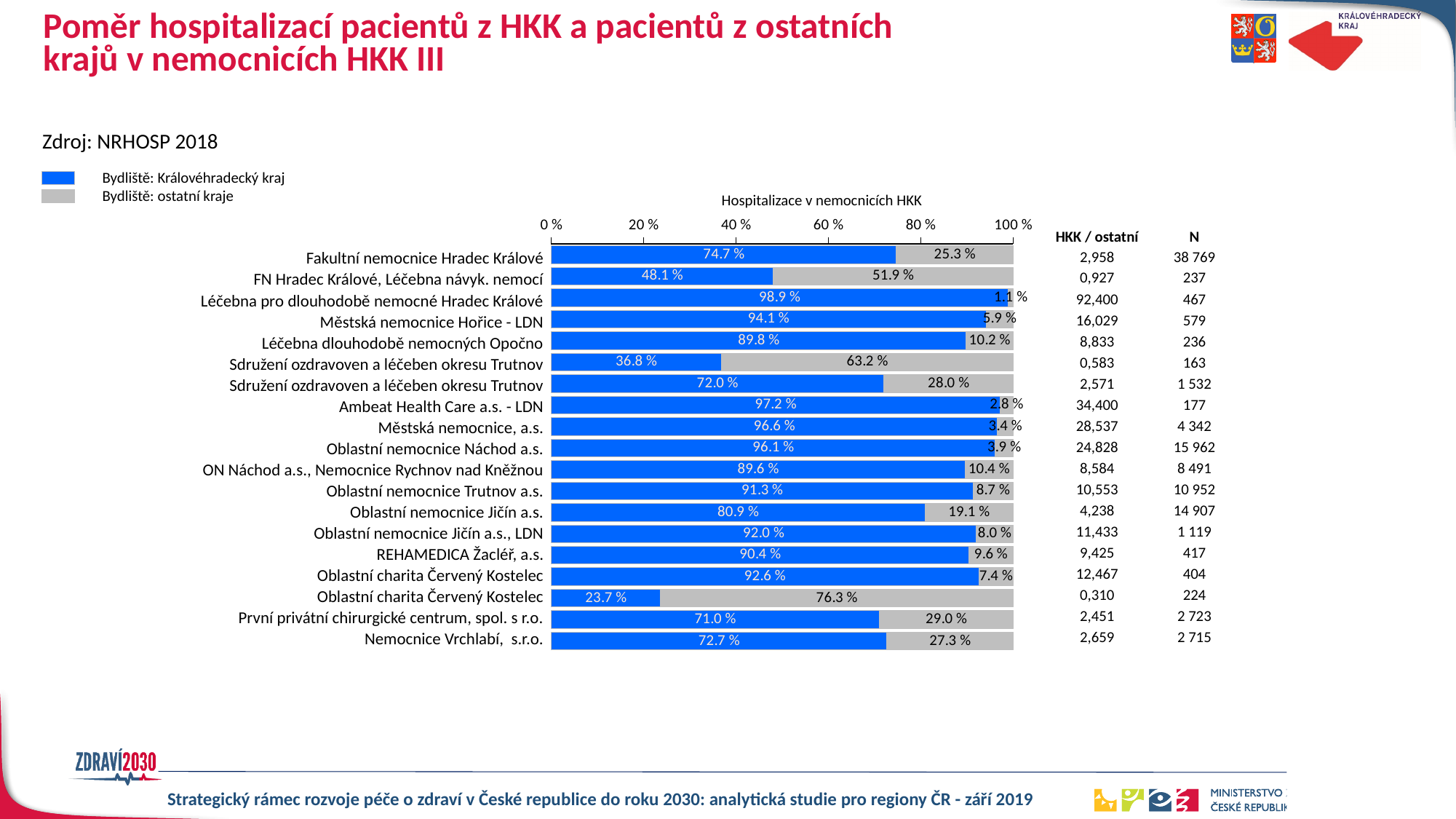
Which hospital has the highest share of patients with Bydliště: Královéhradecký kraj? Léčebna pro dlouhodobě nemocné Hradec Králové Which has a larger Bydliště: Královéhradecký kraj share, Oblastní nemocnice Jičín a.s. or Oblastní nemocnice Trutnov a.s.? Oblastní nemocnice Trutnov a.s. Which hospital has the lowest share of patients with Bydliště: Královéhradecký kraj? Oblastní charita Červený Kostelec How many hospitals (categories) are plotted in the chart? 19 What is the value for Bydliště: Královéhradecký kraj for Fakultní nemocnice Hradec Králové? 74.7 % What kind of chart is shown on the slide? Stacked bar chart What is the title shown above the chart's axis? Hospitalizace v nemocnicích HKK What is the value for Bydliště: Královéhradecký kraj for Ambeat Health Care a.s. - LDN? 97.2 % Is the Bydliště: Královéhradecký kraj value for Nemocnice Vrchlabí, s.r.o. greater or less than 60 %? greater What is the value for Bydliště: ostatní kraje for Oblastní nemocnice Jičín a.s.? 19.1 % What is the difference between the Bydliště: Královéhradecký kraj and Bydliště: ostatní kraje values for Fakultní nemocnice Hradec Králové? 49.4 percentage points How many series does the legend list? 2